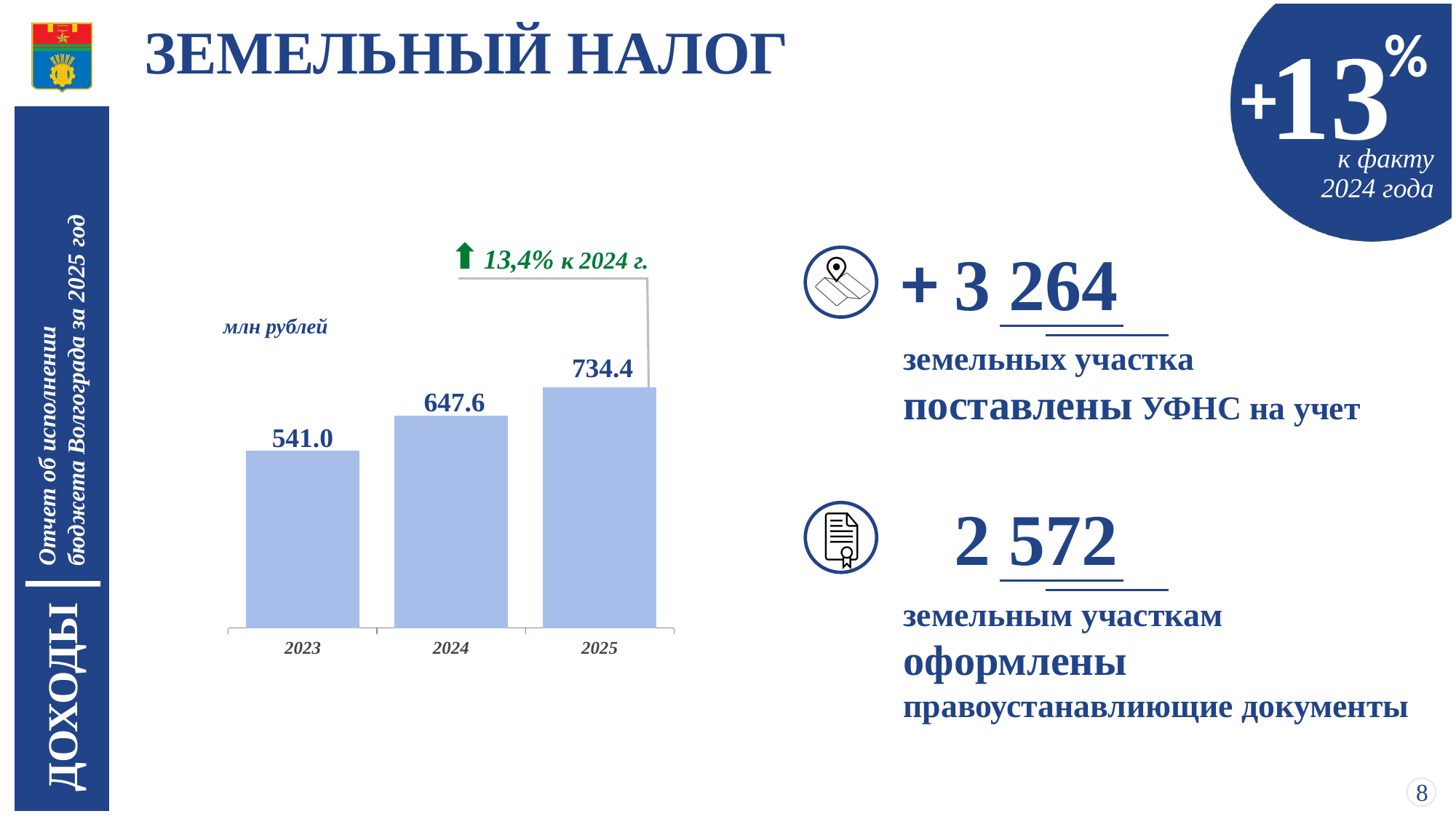
Which is larger on the chart, the value for 2023 or the value for 2025? 2025 What is the difference between the 2025 and 2024 values on the chart? 86.8 How many bars are shown on the chart? 3 What is the value for 2025 on the chart? 734.4 Which year has the highest value on the chart? 2025 What is the value for 2024 on the chart? 647.6 What kind of chart is shown on the slide? Bar chart Which year has the lowest value on the chart? 2023 What is the difference between the 2024 and 2023 values on the chart? 106.6 What unit is indicated for the values on the chart? млн рублей Do the values on the chart rise or fall from 2023 to 2025? Rise What is the value for 2023 on the chart? 541.0